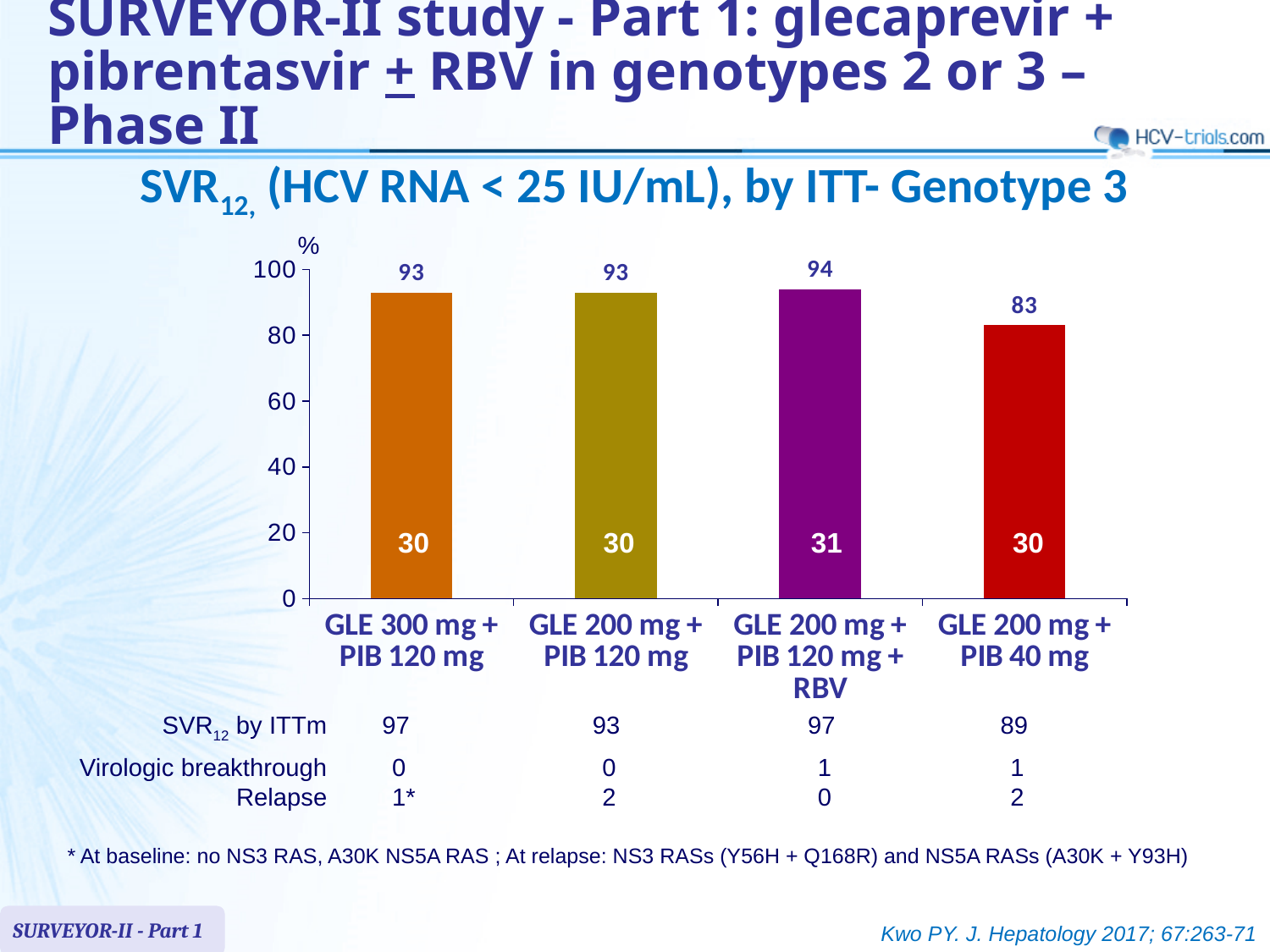
Is the SVR12 value for the GLE 200 mg + PIB 40 mg arm greater or less than 80? greater How many patients (number shown inside the bar) are in the GLE 200 mg + PIB 120 mg + RBV arm? 31 Which arm has a higher SVR12 rate: GLE 200 mg + PIB 120 mg or GLE 200 mg + PIB 40 mg? GLE 200 mg + PIB 120 mg What is the maximum value shown on the y-axis of the chart? 100 Which treatment arm has the lowest SVR12 rate? GLE 200 mg + PIB 40 mg What is the SVR12 value (%) for the GLE 300 mg + PIB 120 mg arm? 93 What is the SVR12 value (%) for the GLE 200 mg + PIB 120 mg + RBV arm? 94 How many treatment arms are shown in the chart? 4 What is the SVR12 value (%) for the GLE 200 mg + PIB 40 mg arm? 83 What is the difference in SVR12 (%) between the GLE 200 mg + PIB 120 mg + RBV arm and the GLE 200 mg + PIB 40 mg arm? 11 What type of chart is shown on the slide? Bar chart Which treatment arm has the highest SVR12 rate? GLE 200 mg + PIB 120 mg + RBV